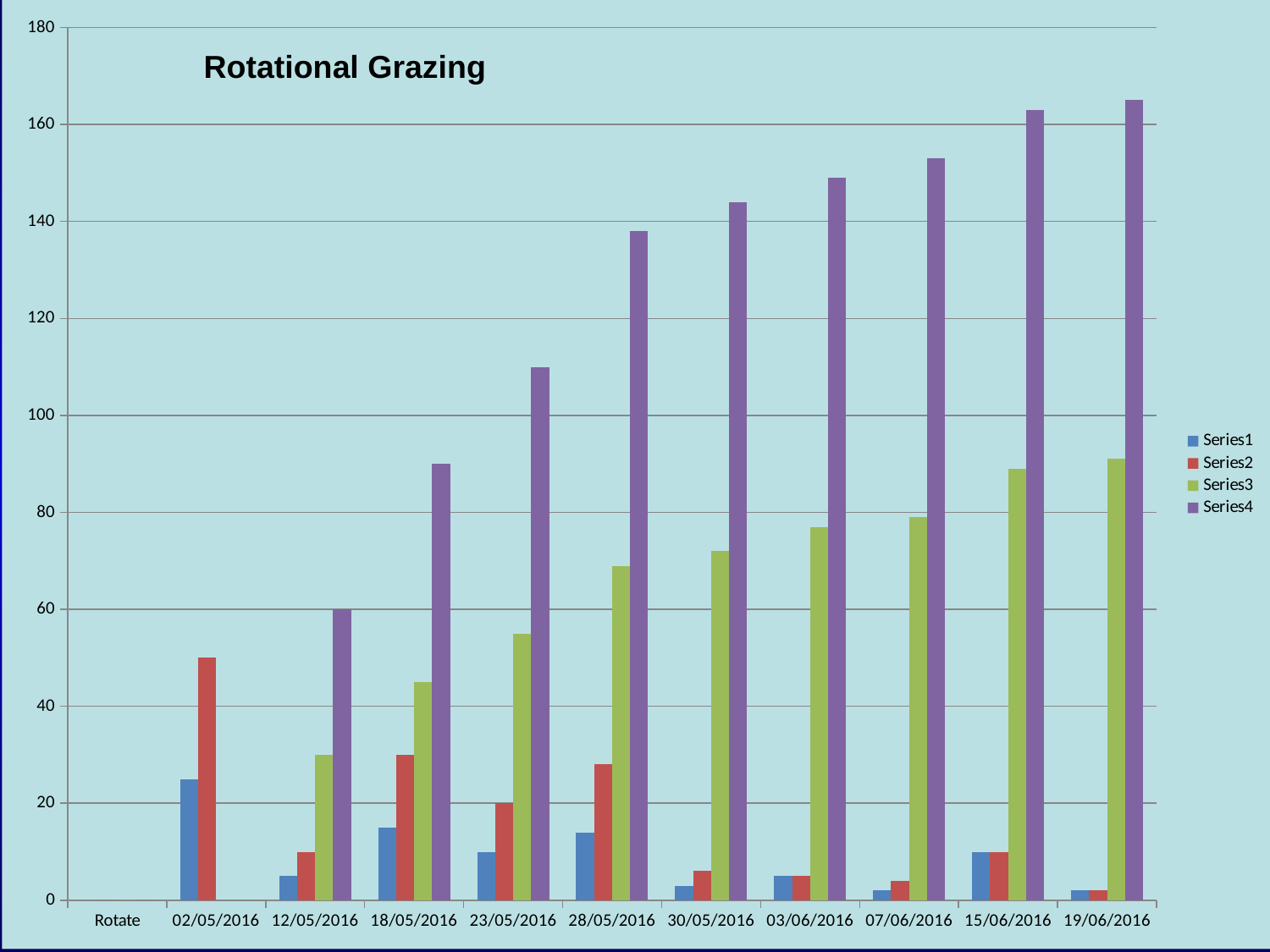
For 28/05/2016, which is larger, Series3 or Series4? Series4 What kind of chart is shown on the slide? bar chart For which category is Series2 highest? 02/05/2016 What is the value of Series4 for 12/05/2016? 60 Is the value of Series4 for 19/06/2016 greater or less than 160? greater Is the value of Series4 for 23/05/2016 greater or less than 100? greater How many series does the legend list? 4 Do the Series4 values rise or fall from 12/05/2016 to 19/06/2016? rise How many categories are shown on the x axis? 11 What is the value of Series2 for 23/05/2016? 20 Is the value of Series3 for 30/05/2016 greater or less than 60? greater What is the title of the chart? Rotational Grazing